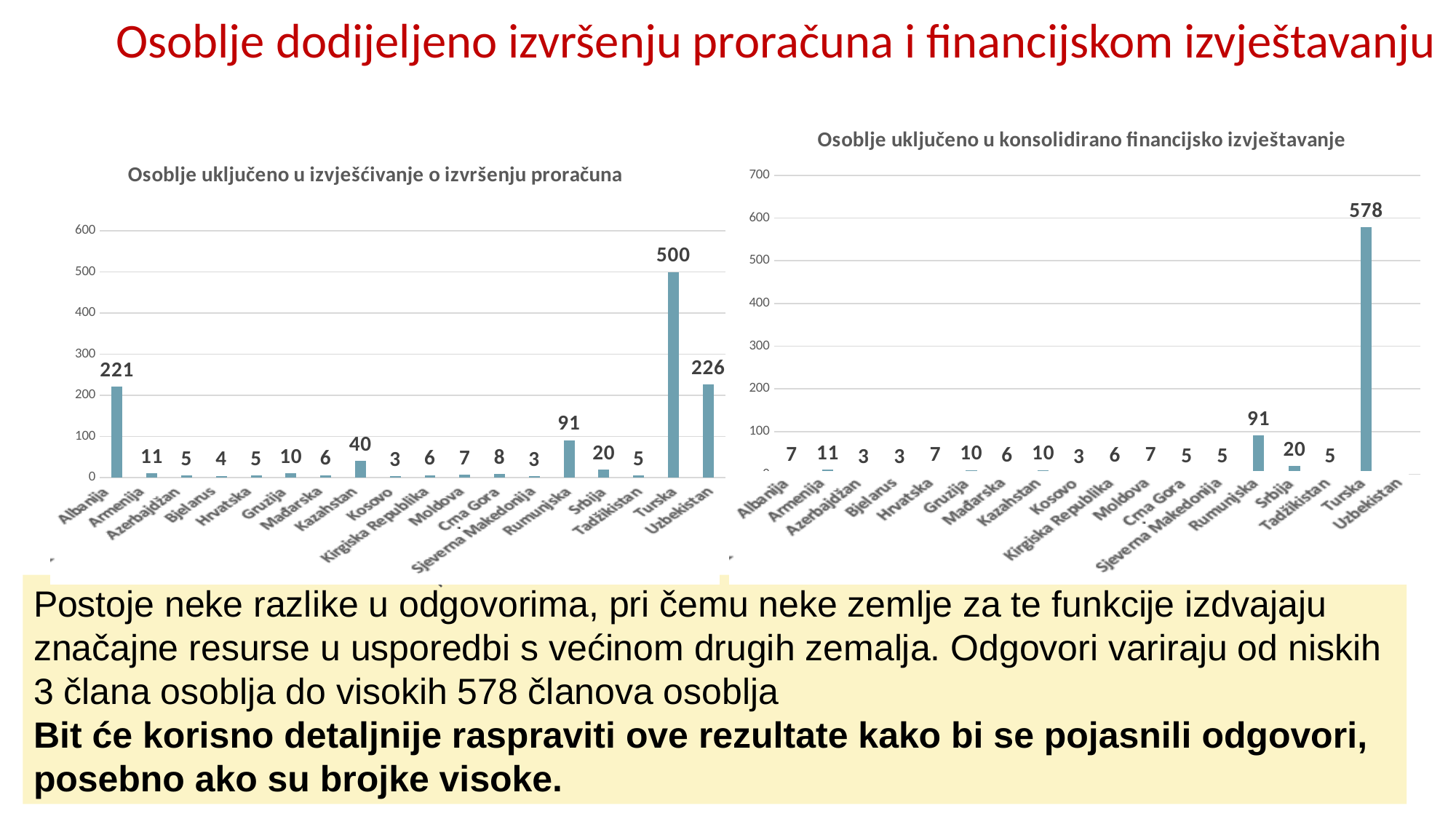
In the left chart (Osoblje uključeno u izvješćivanje o izvršenju proračuna), what is the value for Uzbekistan? 226 In the left chart (Osoblje uključeno u izvješćivanje o izvršenju proračuna), what is the value for Kazahstan? 40 In the right chart (Osoblje uključeno u konsolidirano financijsko izvještavanje), which country has the highest value? Turska In the left chart (Osoblje uključeno u izvješćivanje o izvršenju proračuna), what is the value for Turska? 500 In the right chart (Osoblje uključeno u konsolidirano financijsko izvještavanje), what is the value for Turska? 578 In the left chart (Osoblje uključeno u izvješćivanje o izvršenju proračuna), which country has the highest value? Turska In the right chart (Osoblje uključeno u konsolidirano financijsko izvještavanje), what is the value for Rumunjska? 91 In the right chart (Osoblje uključeno u konsolidirano financijsko izvještavanje), what is the value for Srbija? 20 In the left chart (Osoblje uključeno u izvješćivanje o izvršenju proračuna), what is the difference between the values for Uzbekistan and Albanija? 5 What type of chart is the left chart (Osoblje uključeno u izvješćivanje o izvršenju proračuna)? Bar chart In the left chart (Osoblje uključeno u izvješćivanje o izvršenju proračuna), which is larger, the value for Rumunjska or the value for Kazahstan? Rumunjska In the right chart (Osoblje uključeno u konsolidirano financijsko izvještavanje), what is the difference between the values for Turska and Rumunjska? 487